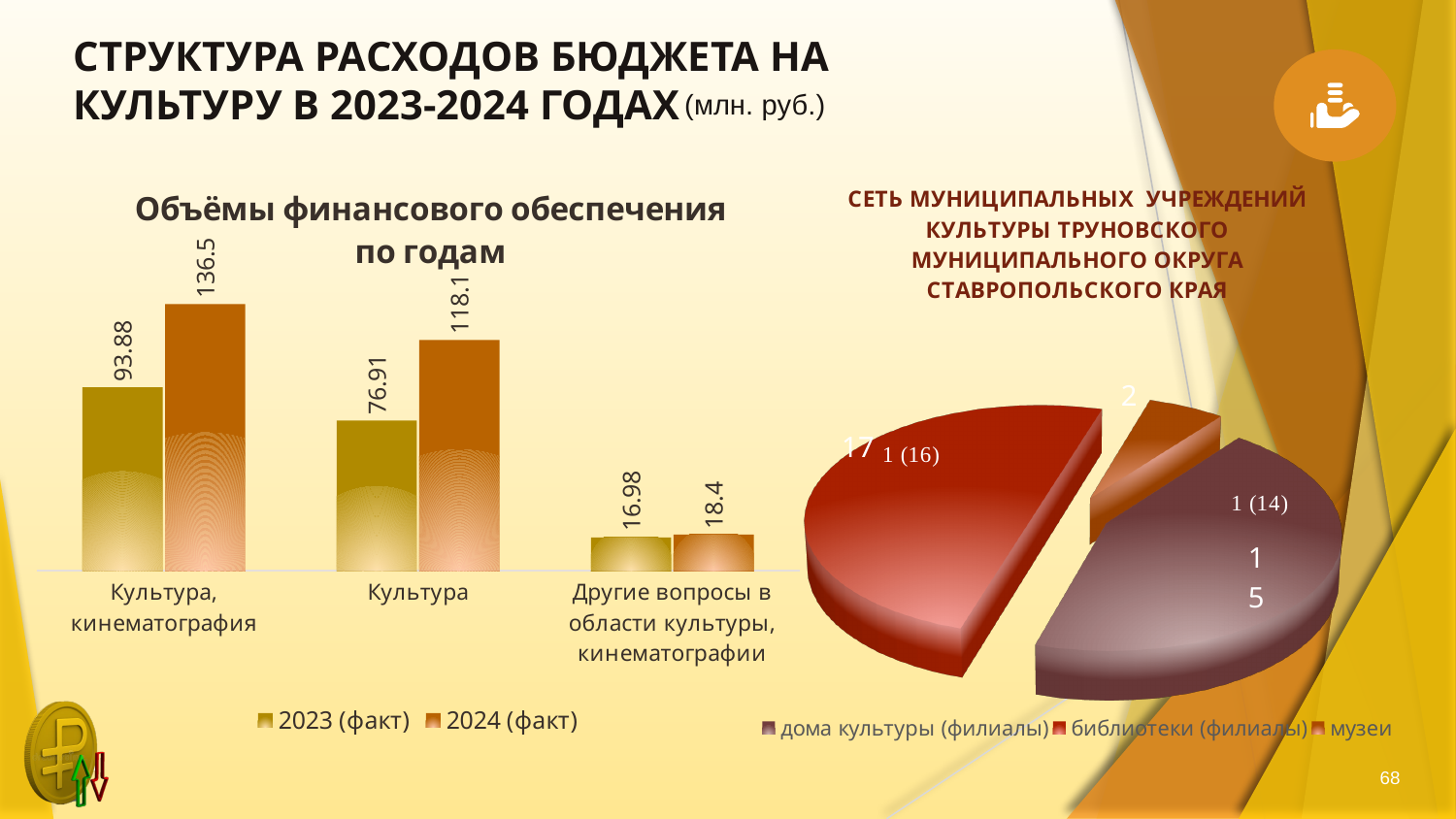
In the bar chart 'Объёмы финансового обеспечения по годам', what is the difference between the 2024 (факт) and 2023 (факт) values for 'Культура, кинематография'? 42.62 How many series does the legend of the bar chart 'Объёмы финансового обеспечения по годам' list? 2 How many entries does the legend of the pie chart on the right of the slide list? 3 How many categories are shown in the bar chart 'Объёмы финансового обеспечения по годам'? 3 What kind of chart is the chart on the right of the slide, titled 'СЕТЬ МУНИЦИПАЛЬНЫХ УЧРЕЖДЕНИЙ КУЛЬТУРЫ ТРУНОВСКОГО МУНИЦИПАЛЬНОГО ОКРУГА СТАВРОПОЛЬСКОГО КРАЯ'? Pie chart In the bar chart 'Объёмы финансового обеспечения по годам', which category has the highest 2024 (факт) value? Культура, кинематография In the bar chart 'Объёмы финансового обеспечения по годам', what is the 2024 (факт) value for 'Культура, кинематография'? 136.5 In the bar chart 'Объёмы финансового обеспечения по годам', which is larger for 'Другие вопросы в области культуры, кинематографии': the 2023 (факт) value or the 2024 (факт) value? 2024 (факт) In the bar chart 'Объёмы финансового обеспечения по годам', what is the 2024 (факт) value for 'Другие вопросы в области культуры, кинематографии'? 18.4 In the bar chart 'Объёмы финансового обеспечения по годам', which category has the lowest 2023 (факт) value? Другие вопросы в области культуры, кинематографии In the bar chart 'Объёмы финансового обеспечения по годам', what is the 2023 (факт) value for 'Культура'? 76.91 In the bar chart 'Объёмы финансового обеспечения по годам', what is the difference between the 2024 (факт) and 2023 (факт) values for 'Культура'? 41.19